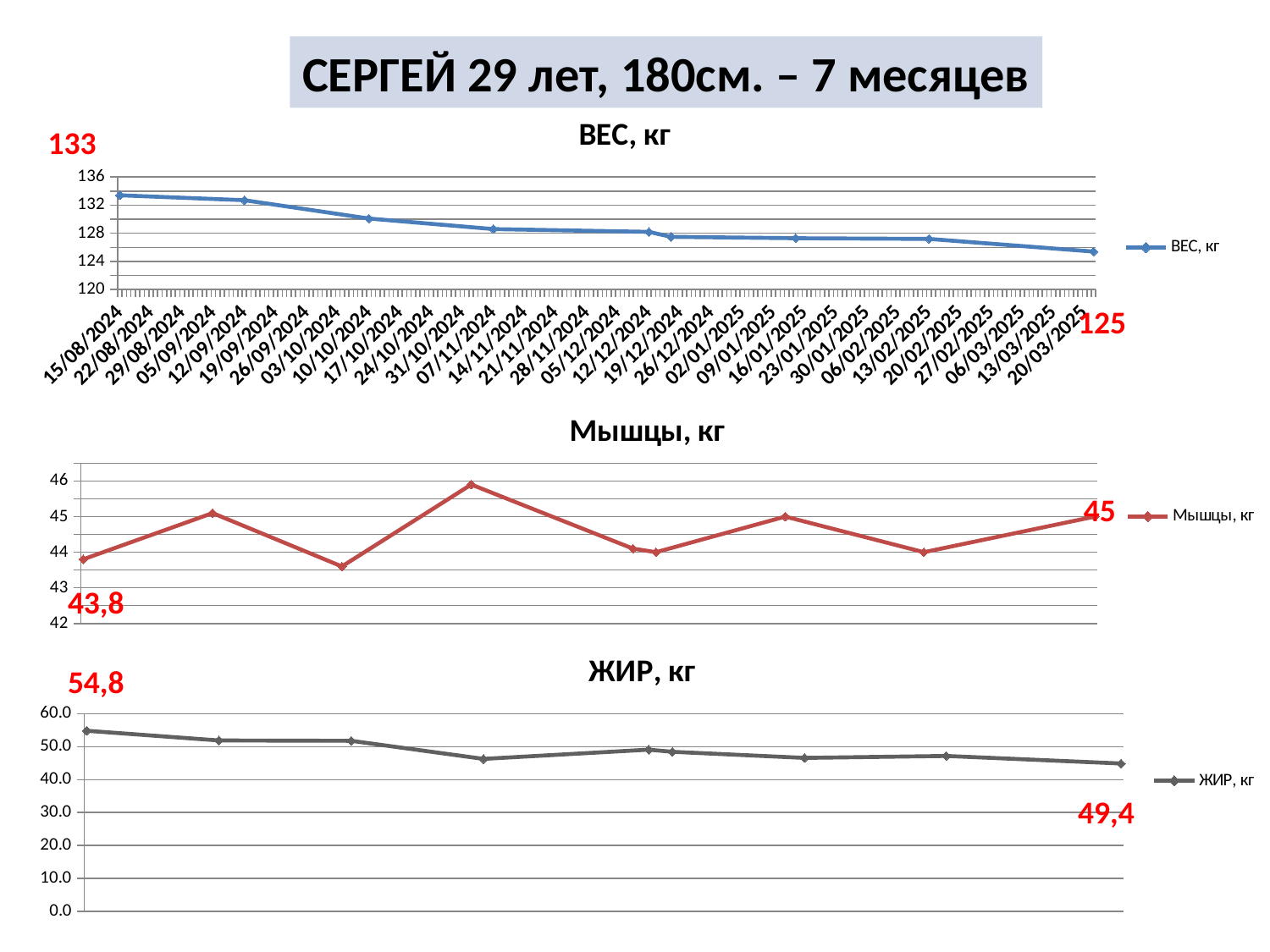
In the "ЖИР, кг" chart, what is the first plotted value? 54,8 In the "Мышцы, кг" chart, what is the last plotted value? 45 How many series does the legend of the "Мышцы, кг" chart list? 1 In the "Мышцы, кг" chart, what is the first plotted value? 43,8 In the "ЖИР, кг" chart, is the last plotted value greater or less than 50.0? less In the "ВЕС, кг" chart, what is the value for 15/08/2024? 133 In the "ВЕС, кг" chart, what is the difference between the value for 15/08/2024 and the value for 20/03/2025? 8 In the "ВЕС, кг" chart, is the value for 20/03/2025 greater or less than 128? less In the "ВЕС, кг" chart, do the values rise or fall from 15/08/2024 to 20/03/2025? fall In the "Мышцы, кг" chart, is the highest plotted value greater or less than 45? greater What kind of chart is the "ВЕС, кг" chart? line chart In the "ВЕС, кг" chart, what is the value for 20/03/2025? 125